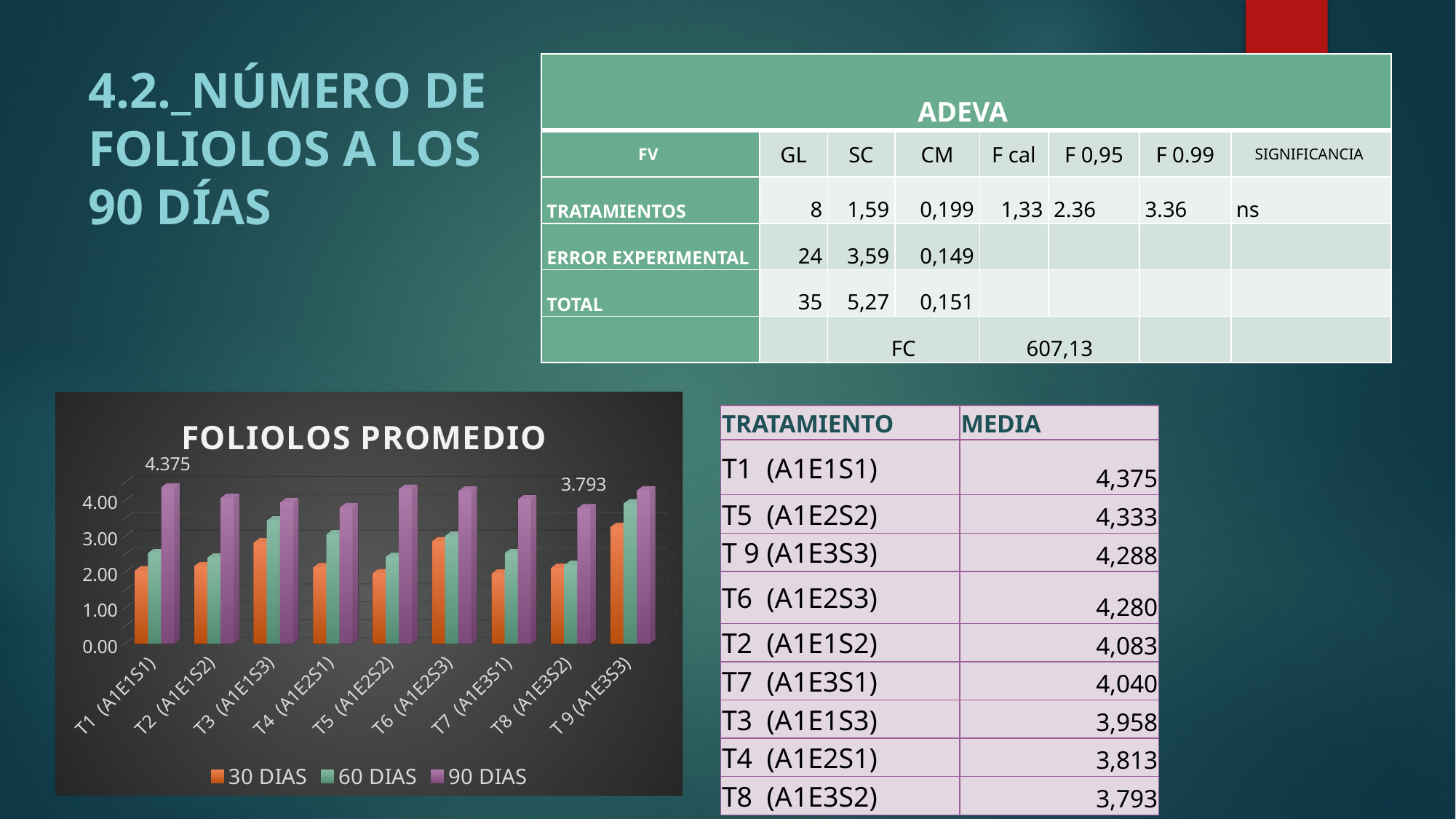
In the FOLIOLOS PROMEDIO chart, is the 30 DIAS value for T1 (A1E1S1) greater or less than 3.00? less In the FOLIOLOS PROMEDIO chart, is the 90 DIAS value for T1 (A1E1S1) greater or less than 4.00? greater How many series does the legend of the FOLIOLOS PROMEDIO chart list? 3 In the FOLIOLOS PROMEDIO chart, is the 60 DIAS value for T9 (A1E3S3) greater or less than 3.00? greater In the FOLIOLOS PROMEDIO chart, what is the 90 DIAS value for T8 (A1E3S2)? 3.793 In the FOLIOLOS PROMEDIO chart, which is larger: the 90 DIAS value for T1 (A1E1S1) or for T8 (A1E3S2)? T1 (A1E1S1) In the FOLIOLOS PROMEDIO chart, for T1 (A1E1S1), do the values rise or fall from 30 DIAS to 90 DIAS? rise How many treatment categories are shown on the x axis of the FOLIOLOS PROMEDIO chart? 9 In the FOLIOLOS PROMEDIO chart, what is the difference between the 90 DIAS values for T1 (A1E1S1) and T8 (A1E3S2)? 0.582 In the FOLIOLOS PROMEDIO chart, what is the 90 DIAS value for T1 (A1E1S1)? 4.375 In the FOLIOLOS PROMEDIO chart, which series is shown in purple? 90 DIAS What kind of chart is the FOLIOLOS PROMEDIO chart? bar chart